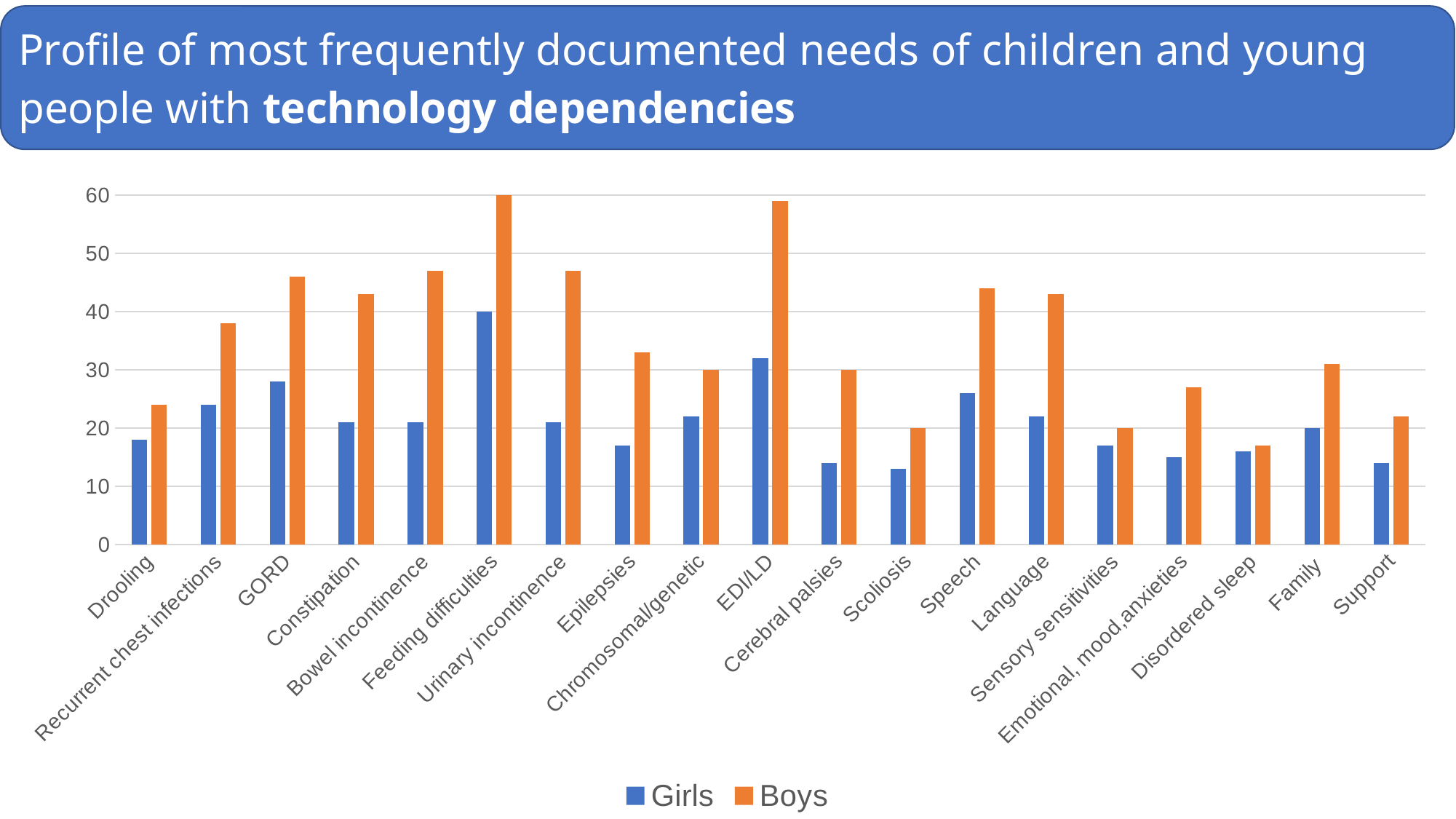
What is the difference between the Boys and Girls values for Feeding difficulties? 20 Which category has the highest Girls value? Feeding difficulties Is the Boys value for GORD greater or less than 40? greater What is the Girls value for Feeding difficulties? 40 Which series is shown in orange? Boys Which category has the lowest Boys value? Disordered sleep For Constipation, which is larger, the Girls value or the Boys value? Boys What kind of chart is shown on the slide? bar chart What is the Boys value for Feeding difficulties? 60 How many series does the legend list? 2 Is the Girls value for Drooling greater or less than 20? less How many categories are shown on the x axis? 19